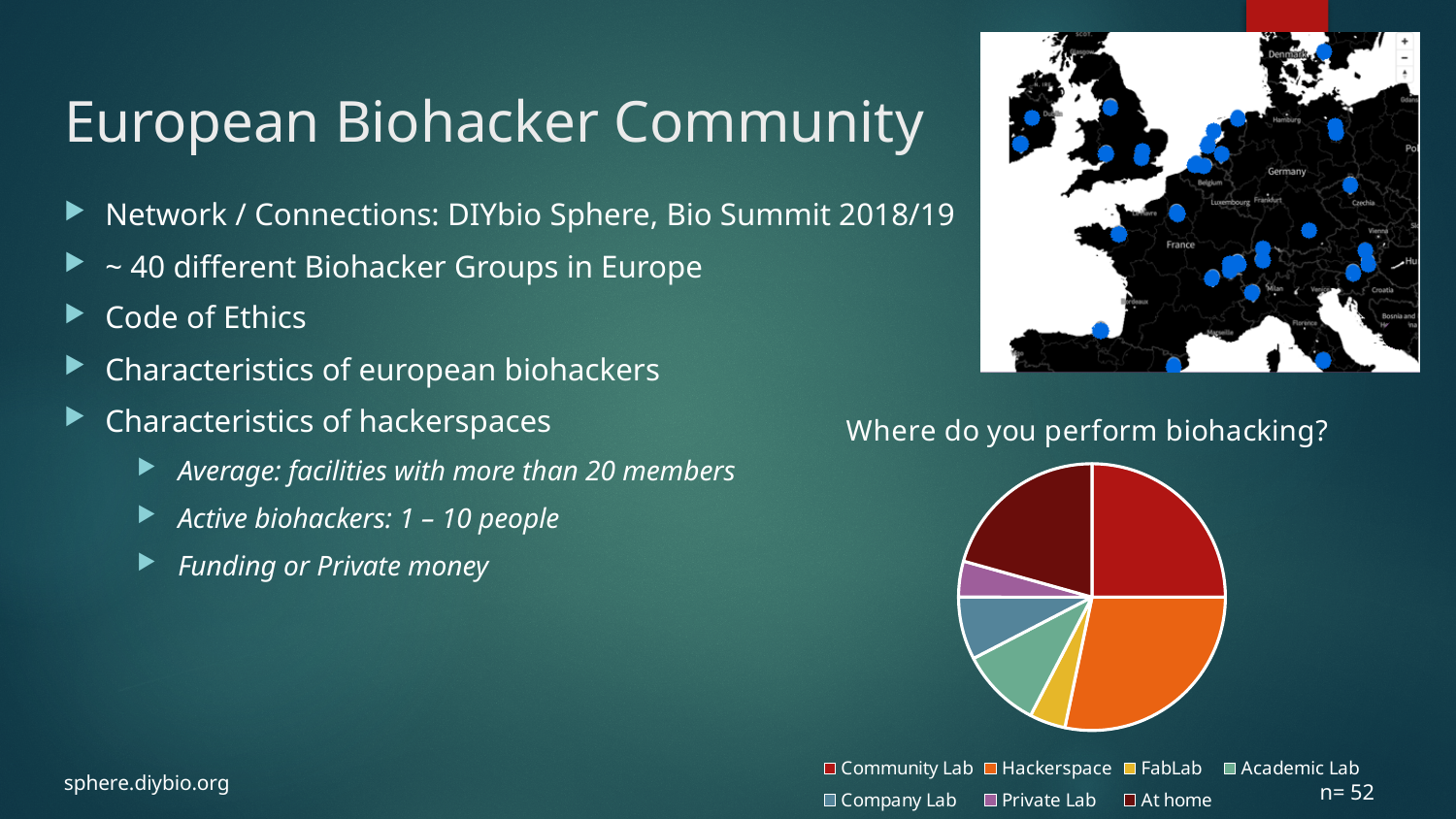
What sample size (n) is given for the pie chart? n= 52 Which category has the largest slice in the pie chart? Hackerspace What kind of chart is shown under "Where do you perform biohacking?"? pie chart In the pie chart, which slice is larger: At home or Academic Lab? At home How many categories does the legend of the pie chart list? 7 What is the title of the pie chart on the slide? Where do you perform biohacking? In the pie chart, which slice is larger: Hackerspace or FabLab? Hackerspace In the pie chart, which slice is larger: Community Lab or Company Lab? Community Lab